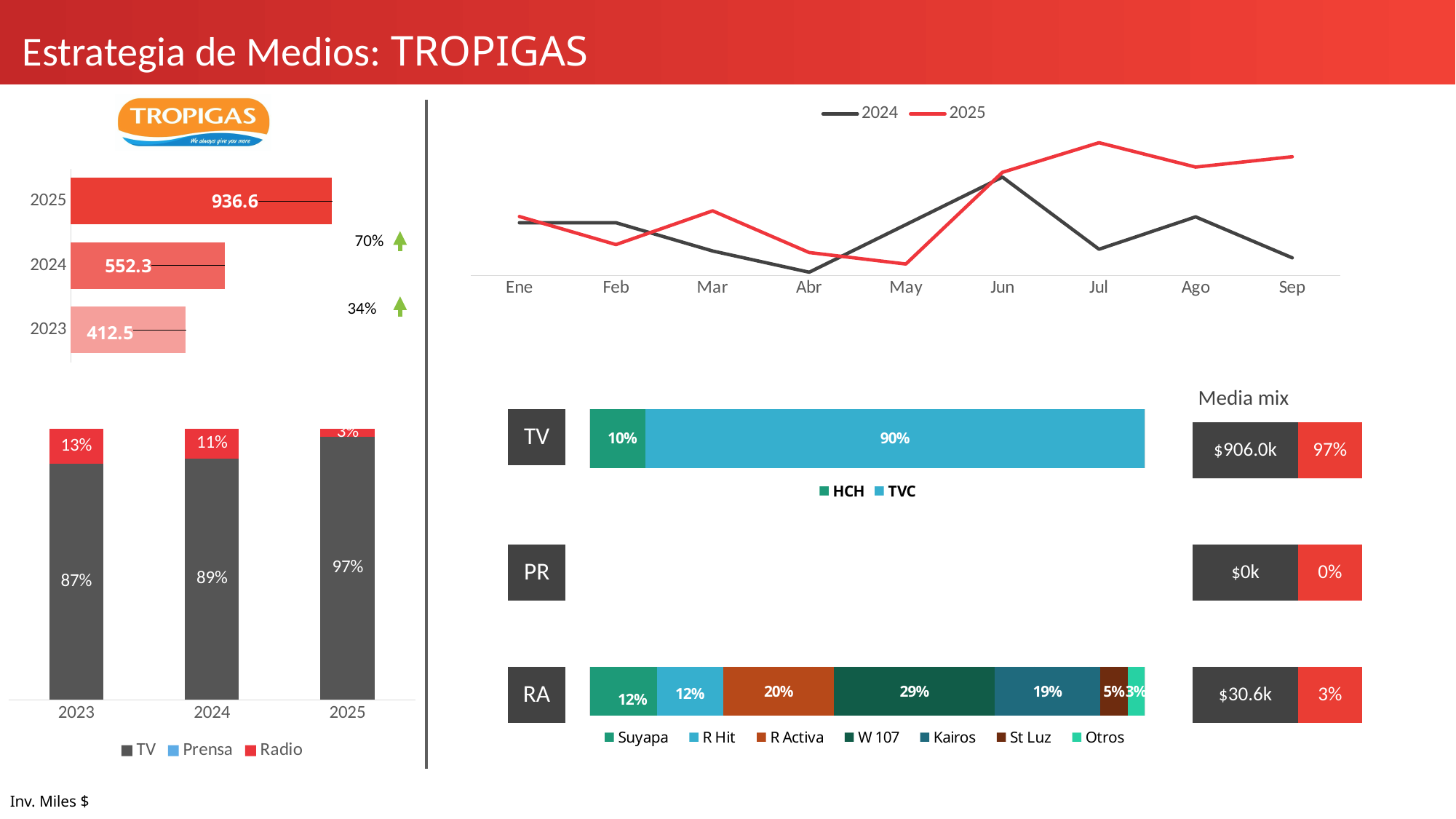
In the RA stacked bar chart, which station has the largest share? W 107 In the top-right line chart, which series is higher in Jul, 2024 or 2025? 2025 In the top-right line chart, how many months are shown on the x axis? 9 In the top-left horizontal bar chart of yearly investment, which year has the highest value? 2025 In the top-left horizontal bar chart of yearly investment, what is the value for 2023? 412.5 In the top-left horizontal bar chart of yearly investment, what is the difference between the 2025 and 2024 values? 384.3 In the bottom-left stacked bar chart by year, how many series does the legend list? 3 In the bottom-left stacked bar chart by year, what is the TV share for 2024? 89% In the Media mix panel, what is the investment amount shown for RA? $30.6k In the bottom-left stacked bar chart by year, what is the Radio share for 2025? 3% In the TV stacked bar chart, what is the share for TVC? 90% In the top-left horizontal bar chart of yearly investment, what is the value for 2025? 936.6